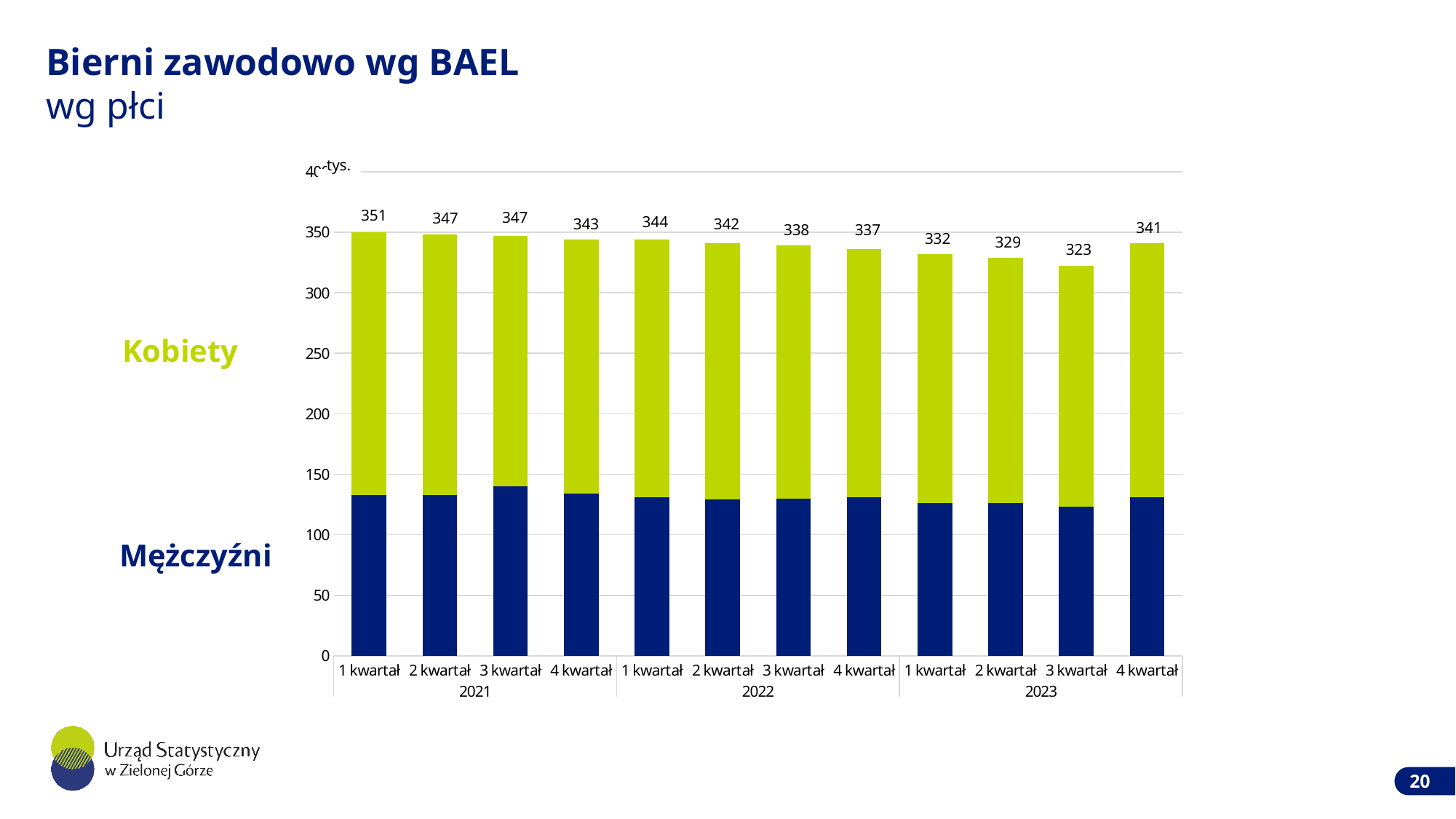
What is the total value of the bar for 1 kwartał 2021? 351 Which total is larger: 4 kwartał 2022 or 4 kwartał 2023? 4 kwartał 2023 What kind of chart is shown on the slide? bar chart Which quarter has the highest total bar value? 1 kwartał 2021 Which quarter has the lowest total bar value? 3 kwartał 2023 Do the total bar values rise or fall from 1 kwartał 2021 to 3 kwartał 2023? fall How many bars (quarters) are plotted in the chart? 12 What is the total value of the bar for 3 kwartał 2023? 323 What is the difference between the total for 1 kwartał 2021 and the total for 3 kwartał 2023? 28 How many series are shown in the stacked bars? 2 Is the value for Mężczyźni in 1 kwartał 2021 greater or less than 100? greater What is the total value of the bar for 2 kwartał 2022? 342